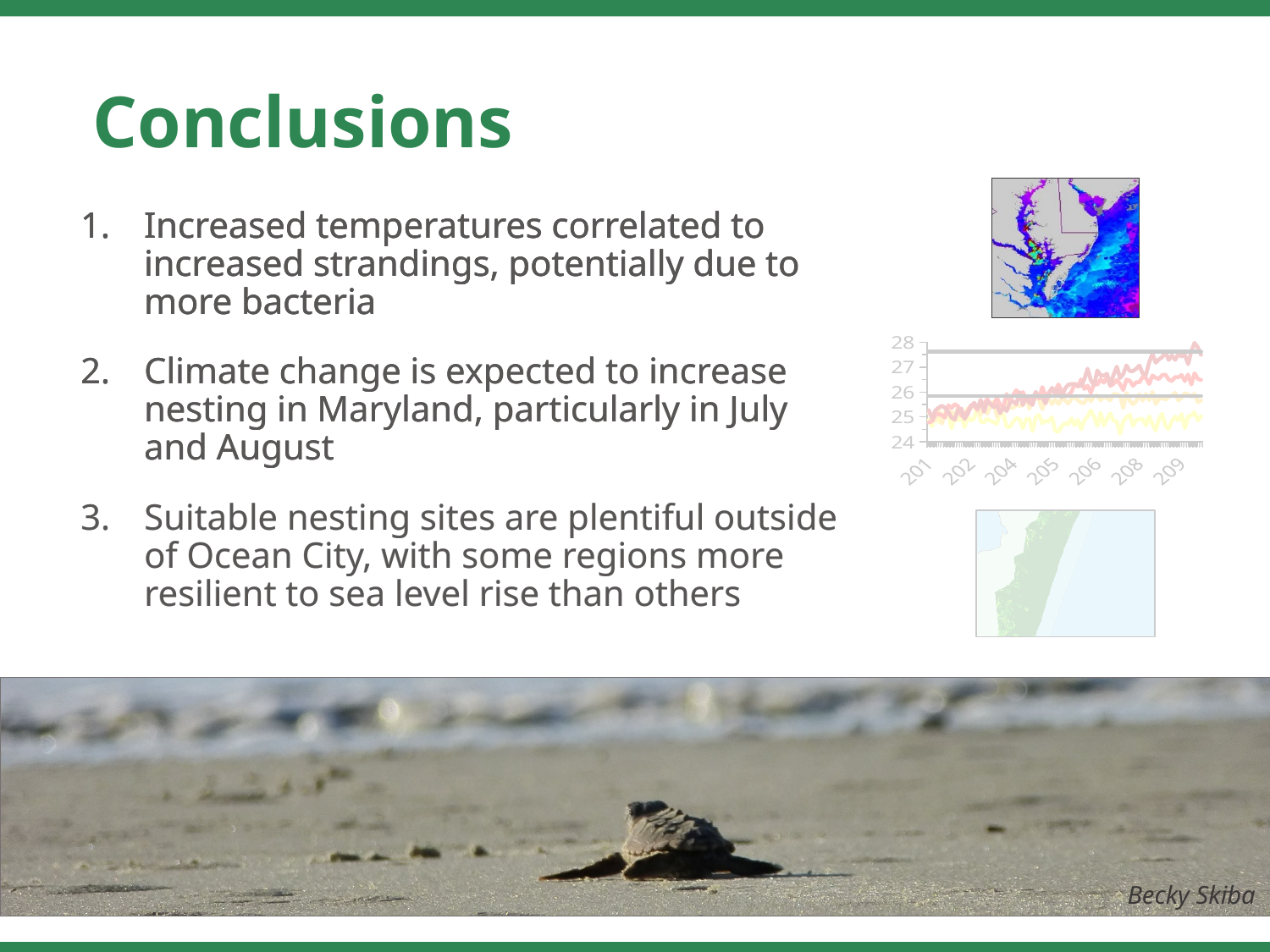
In the line chart on the right, is the red line at the far left end of the x axis greater or less than 27? less In the line chart on the right, which line is higher at the far right end of the x axis, the red line or the yellow line? the red line In the line chart on the right, is the red line at the far right end of the x axis greater or less than 26? greater What kind of chart is the small chart on the right side of the slide? line chart What is the highest value shown on the y axis of the line chart on the right? 28 In the line chart on the right, is the yellow line at the far left end of the x axis greater or less than 26? less In the line chart on the right, do the plotted values generally rise or fall from left to right along the x axis? rise What is the lowest value shown on the y axis of the line chart on the right? 24